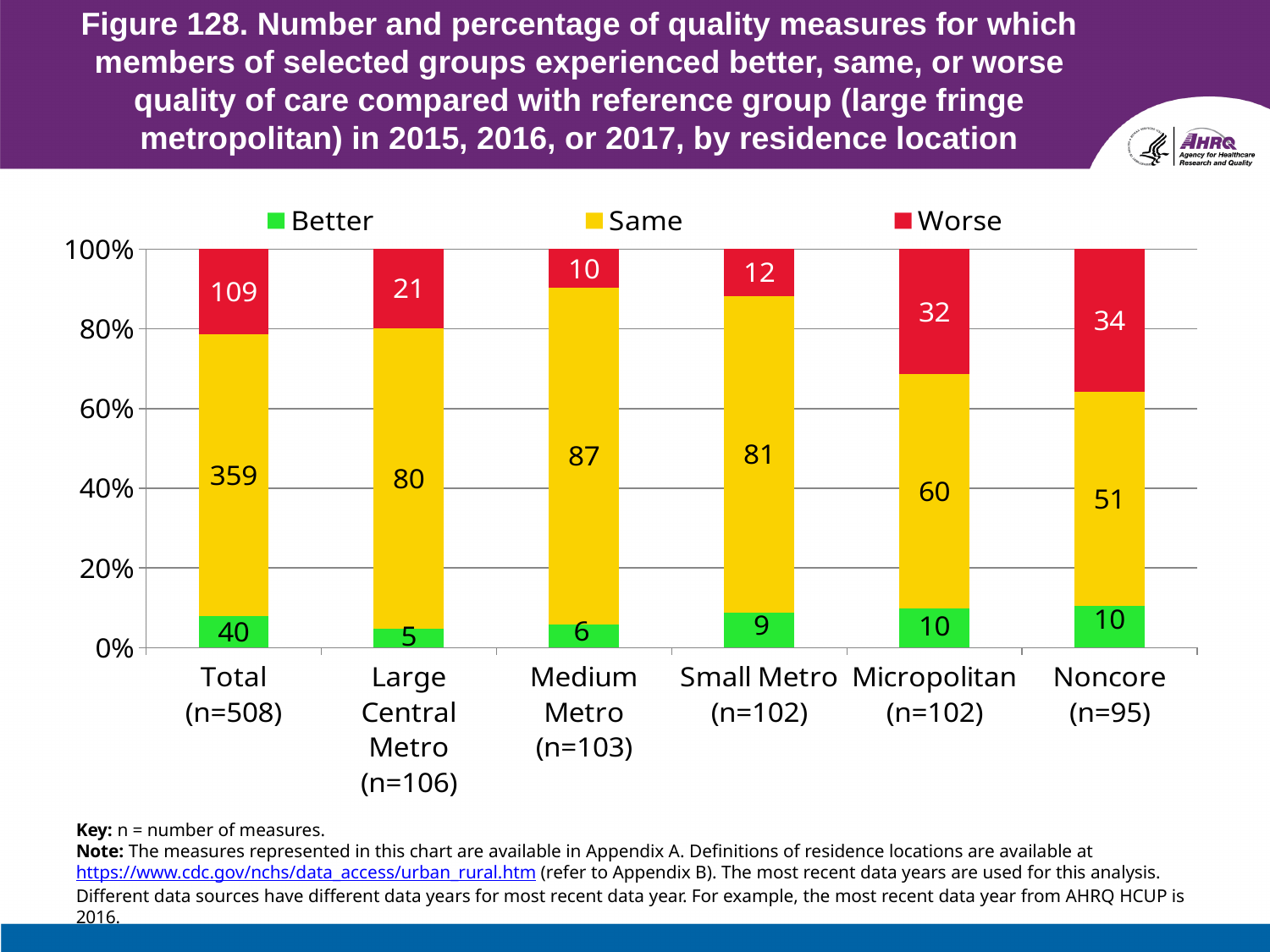
How many residence location categories are shown on the x axis? 6 Is the Better share of the Total (n=508) bar greater or less than 20%? less What is the difference between the Worse counts for Noncore and Micropolitan? 2 How many series does the legend list? 3 Which residence location has the smallest Better count? Large Central Metro (n=106) What kind of chart is shown on the slide? stacked bar chart What is the Worse count for Noncore (n=95)? 34 How many quality measures were rated Same for Medium Metro (n=103)? 87 What is the Better count for Large Central Metro (n=106)? 5 Which has a larger Same count, Small Metro or Medium Metro? Medium Metro What is the total number of measures in the Small Metro bar (Better + Same + Worse)? 102 Excluding the Total bar, which residence location has the largest Worse count? Noncore (n=95)